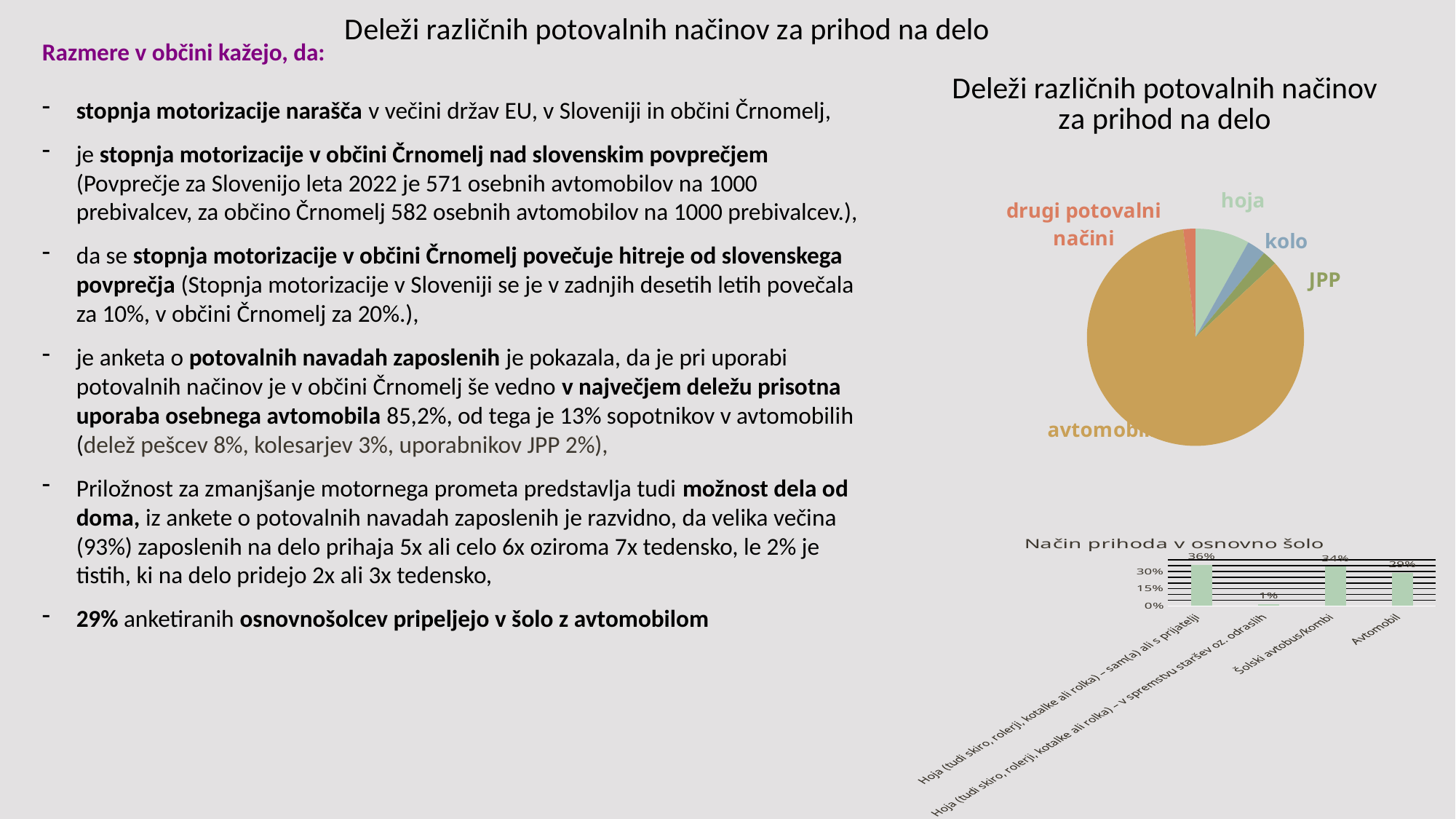
In the bar chart 'Način prihoda v osnovno šolo', what is the difference between the value for Šolski avtobus/kombi and the value for Avtomobili? 5 percentage points In the bar chart 'Način prihoda v osnovno šolo', is the value for Avtomobili greater or less than 15%? greater In the bar chart 'Način prihoda v osnovno šolo', what is the value for Avtomobili? 29% In the bar chart 'Način prihoda v osnovno šolo', what is the value for Šolski avtobus/kombi? 34% In the pie chart 'Deleži različnih potovalnih načinov za prihod na delo', which category has the largest slice? avtomobili What kind of chart is the chart titled 'Način prihoda v osnovno šolo'? bar chart What kind of chart is the chart titled 'Deleži različnih potovalnih načinov za prihod na delo'? pie chart In the pie chart 'Deleži različnih potovalnih načinov za prihod na delo', which slice is larger, hoja or kolo? hoja In the bar chart 'Način prihoda v osnovno šolo', which category has the highest value? Hoja (tudi skiro, rolerji, kotalke ali rolka) – sam(a) ali s prijatelji In the bar chart 'Način prihoda v osnovno šolo', which category has the lowest value? Hoja (tudi skiro, rolerji, kotalke ali rolka) – v spremstvu staršev oz. odraslih How many categories does the pie chart 'Deleži različnih potovalnih načinov za prihod na delo' show? 5 How many categories does the bar chart 'Način prihoda v osnovno šolo' show? 4